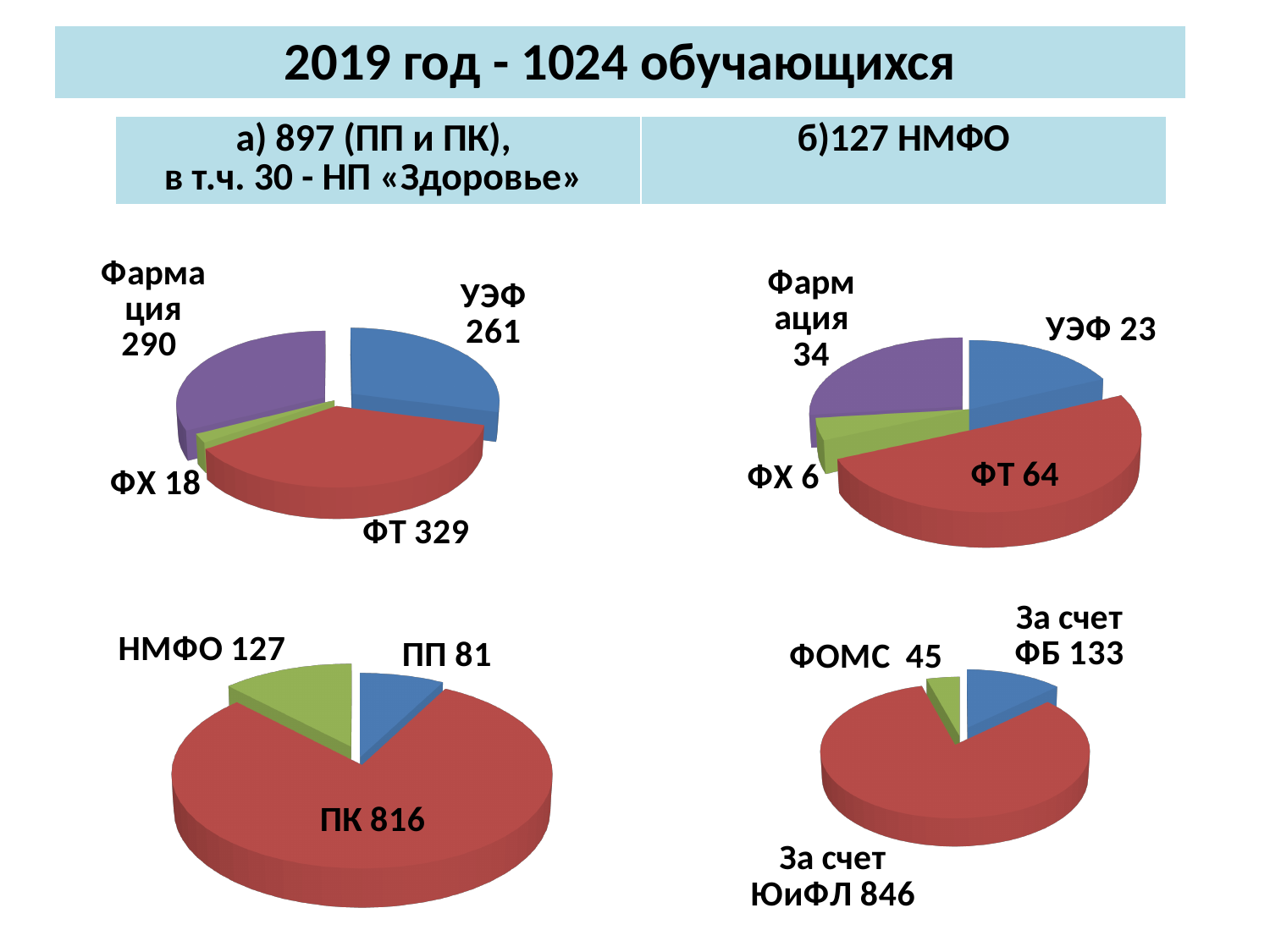
What type of chart is the bottom-right chart? Pie chart In the top-left pie chart, which category has the smallest value? ФХ In the bottom-right pie chart, what is the value for ФОМС? 45 In the top-left pie chart, what is the value for ФТ? 329 In the bottom-right pie chart, what is the difference between the values for За счет ЮиФЛ and За счет ФБ? 713 How many categories does the top-right pie chart show? 4 In the top-left pie chart, what is the value for Фармация? 290 In the top-right pie chart, what is the value for УЭФ? 23 In the bottom-left pie chart, which is larger, НМФО or ПП? НМФО In the bottom-left pie chart, what is the value for ПК? 816 In the top-left pie chart, what is the difference between the values for ФТ and УЭФ? 68 In the top-right pie chart, which category has the largest value? ФТ